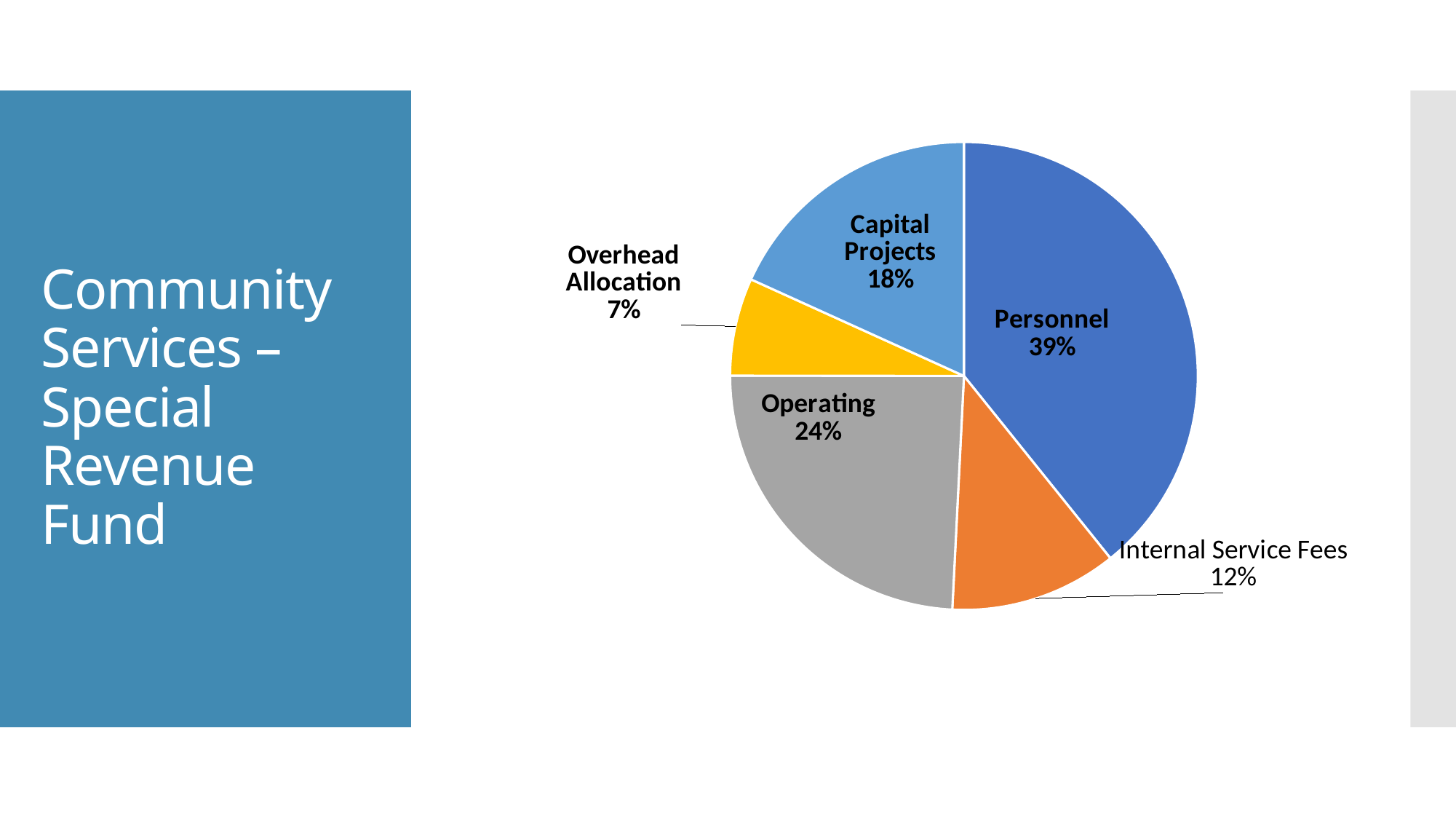
What is the value shown for Internal Service Fees? 12% Which category has the largest slice of the pie? Personnel What is the value shown for Operating? 24% What share of the pie does Personnel represent? 39% What is the difference between the Personnel and Operating shares? 15% Which category has the smallest slice of the pie? Overhead Allocation What colour is the Operating slice? grey What is the value shown for Capital Projects? 18% How many slices does the pie chart have? 5 What kind of chart is shown on the slide? pie chart What is the value shown for Overhead Allocation? 7% Which is larger, Capital Projects or Internal Service Fees? Capital Projects